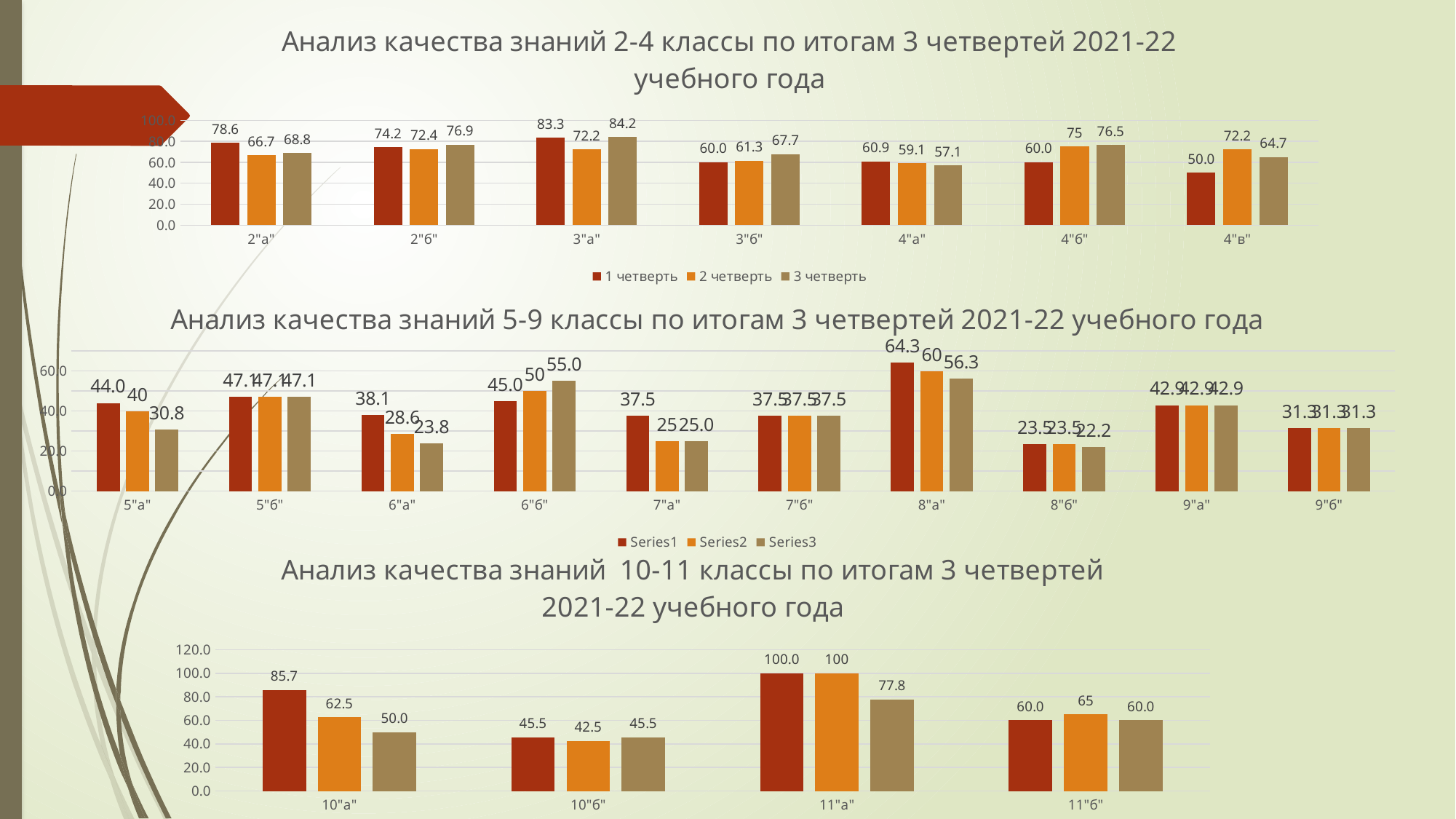
In the chart 'Анализ качества знаний 5-9 классы', how many classes are shown on the x axis? 10 In the chart 'Анализ качества знаний 2-4 классы', which class has the lowest value in 1 четверть? 4"в" What type of chart is the bottom chart 'Анализ качества знаний 10-11 классы'? bar chart In the chart 'Анализ качества знаний 10-11 классы', which class has the highest value in the first series? 11"а" In the chart 'Анализ качества знаний 10-11 классы', what is the value for 11"а" in the third series? 77.8 In the chart 'Анализ качества знаний 10-11 классы', what is the difference between the first-series values for 10"а" and 10"б"? 40.2 In the chart 'Анализ качества знаний 5-9 классы', which is larger: the Series3 value for 5"а" or the Series3 value for 6"а"? 5"а" In the chart 'Анализ качества знаний 2-4 классы', what is the difference between the 1 четверть and 2 четверть values for 2"а"? 11.9 In the chart 'Анализ качества знаний 5-9 классы', do the values for 6"б" rise or fall from Series1 to Series3? rise In the chart 'Анализ качества знаний 2-4 классы', what is the value for 3"а" in 3 четверть? 84.2 In the chart 'Анализ качества знаний 5-9 классы', what is the Series1 value for 8"а"? 64.3 In the chart 'Анализ качества знаний 2-4 классы', how many series does the legend list? 3